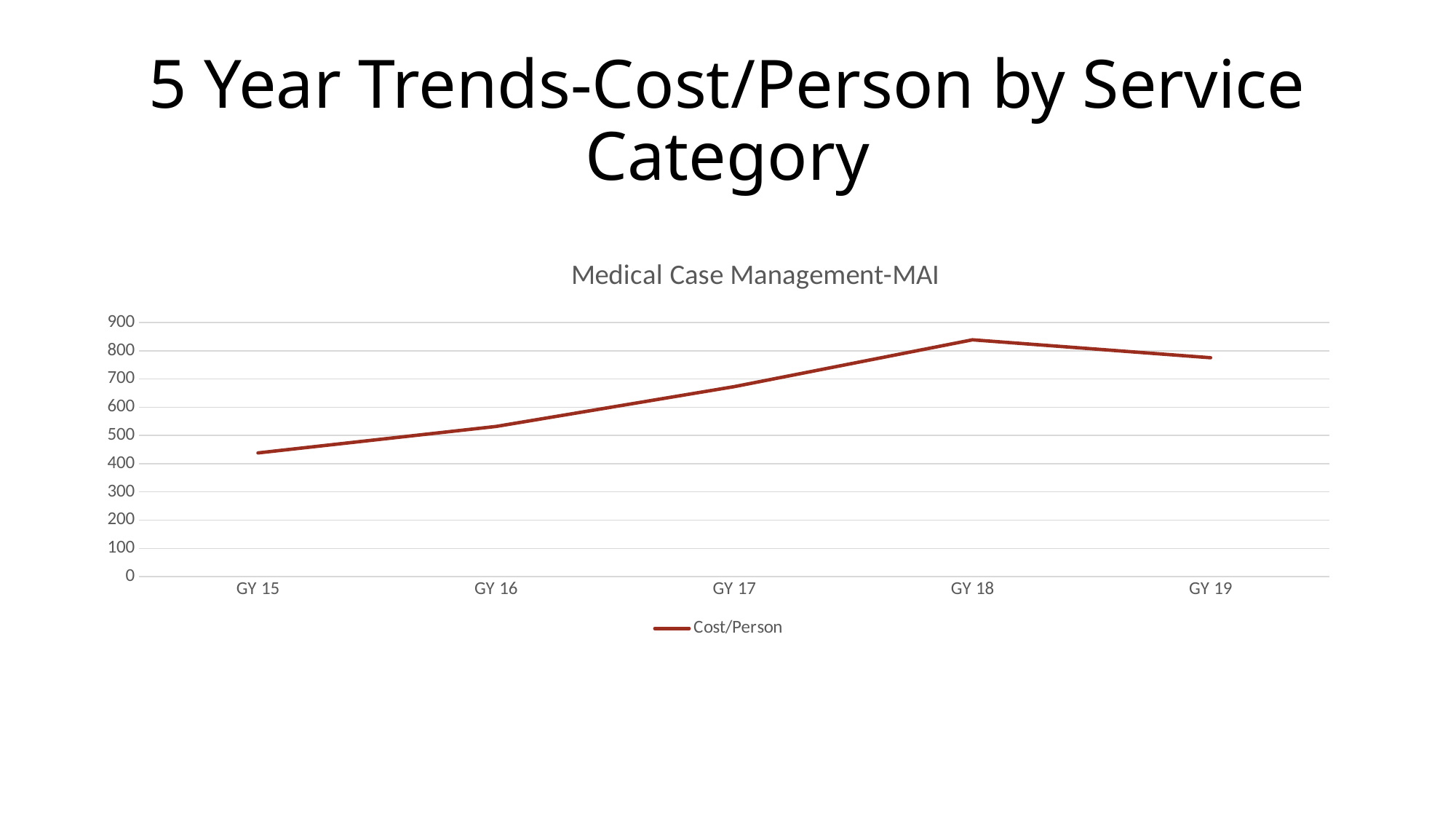
How does Cost/Person change from GY 15 to GY 18? It rises Is the Cost/Person value for GY 18 greater or less than 800? greater What is the title of the chart? Medical Case Management-MAI In which grant year is Cost/Person highest? GY 18 In which grant year is Cost/Person lowest? GY 15 What type of chart is shown on the slide? Line chart What series does the legend list? Cost/Person How many series does the legend list? 1 Is the Cost/Person value for GY 15 greater or less than 500? less Is the Cost/Person value for GY 17 greater or less than 600? greater How many grant years are plotted on the x axis? 5 Which has a higher Cost/Person, GY 18 or GY 19? GY 18